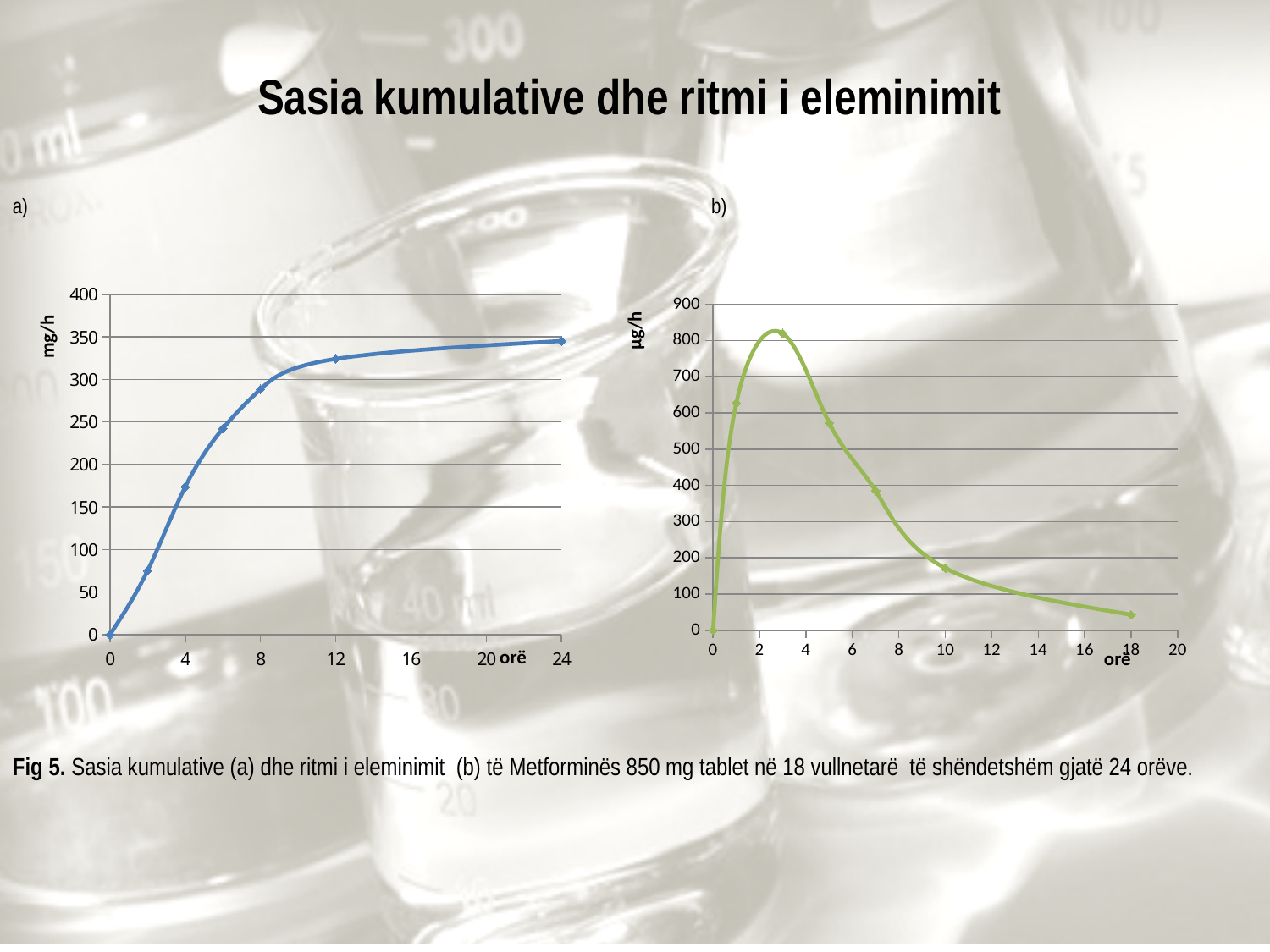
In chart a), is the value at 24 hours greater or less than 300? greater What kind of chart is chart b) on the right? line chart What is the y-axis unit label on chart b)? µg/h In chart a), is the value at 4 hours greater or less than 150? greater In chart b), is the value at 18 hours greater or less than 100? less What kind of chart is chart a) on the left? line chart What is the y-axis unit label on chart a)? mg/h In chart a), do the values rise or fall as the hours increase along the x axis? rise In chart b), after the peak near 3 hours, do the values rise or fall as the hours increase? fall